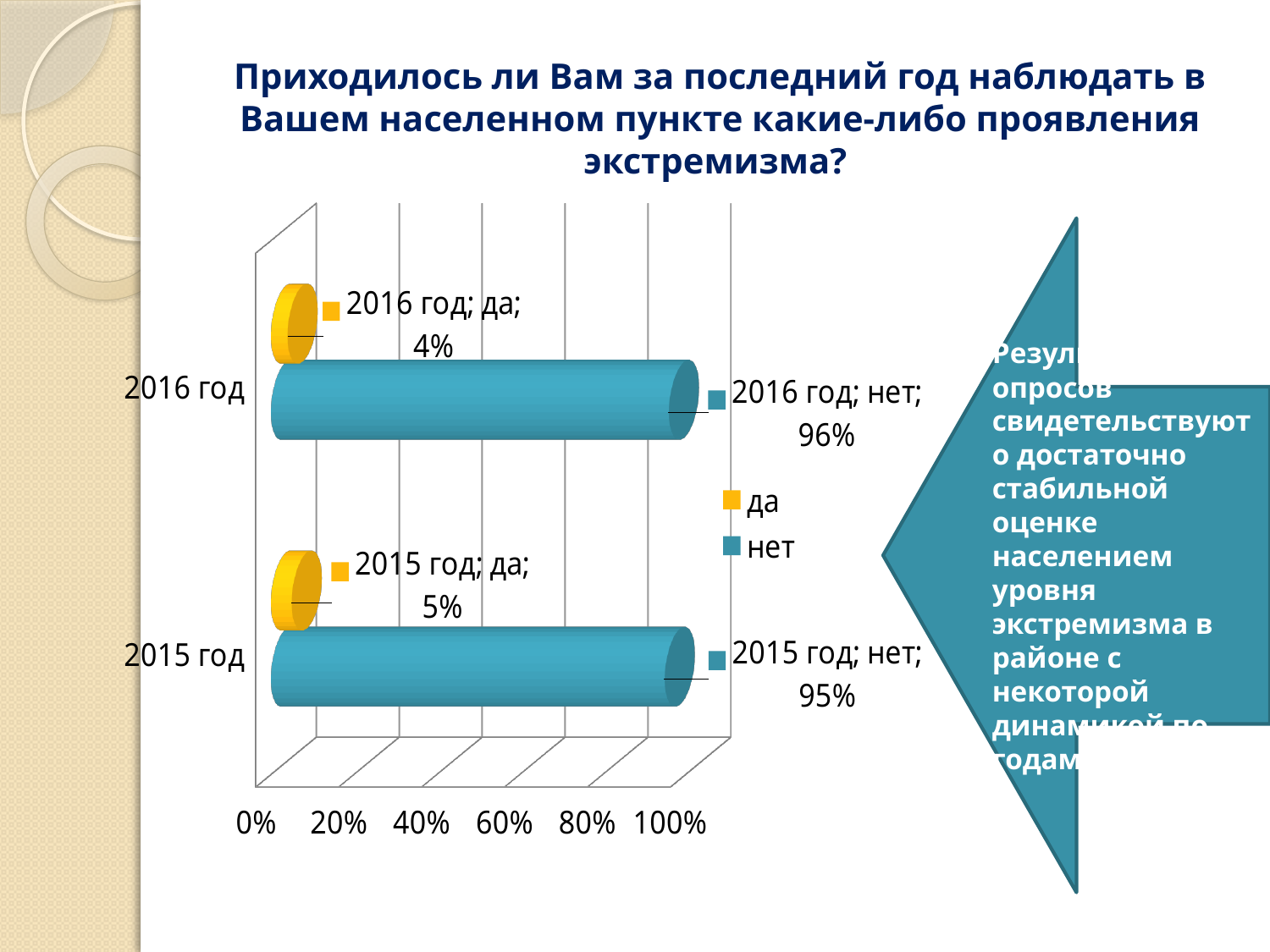
Is the value for "нет" in 2015 год greater or less than 80%? greater What is the value for "да" in 2015 год? 5% Which year has the lower value for "да"? 2016 год What is the difference between the "нет" values for 2016 год and 2015 год? 1% What is the value for "нет" in 2015 год? 95% What kind of chart is shown on the slide? bar chart How many series does the legend list? 2 What is the value for "нет" in 2016 год? 96% Which is larger: "да" in 2015 год or "да" in 2016 год? да in 2015 год Which year has the higher value for "нет"? 2016 год How many year categories are shown on the chart? 2 What is the value for "да" in 2016 год? 4%